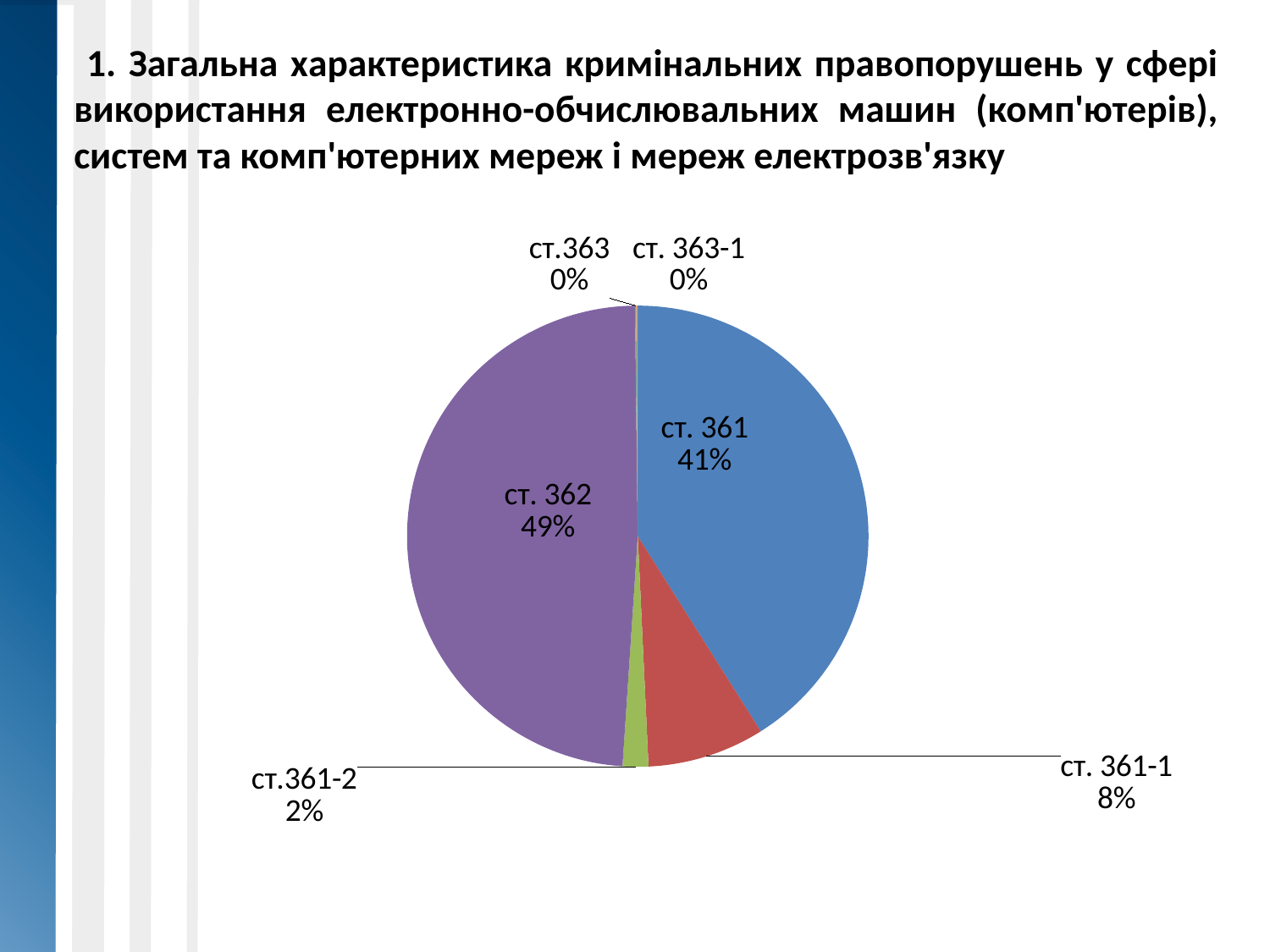
Which category has the largest slice of the pie? ст. 362 What colour is the slice for ст. 362? purple Which is larger, the slice for ст. 361 or the slice for ст. 361-1? ст. 361 What is the difference in percentage points between the shares of ст. 361-1 and ст.361-2? 6 What share of the pie does ст.361-2 have? 2% What kind of chart is shown on the slide? pie chart How many slices (categories) are labelled on the pie chart? 6 What is the difference in percentage points between the shares of ст. 362 and ст. 361? 8 What share of the pie does ст. 361 have? 41% What share of the pie does ст.363 have? 0%